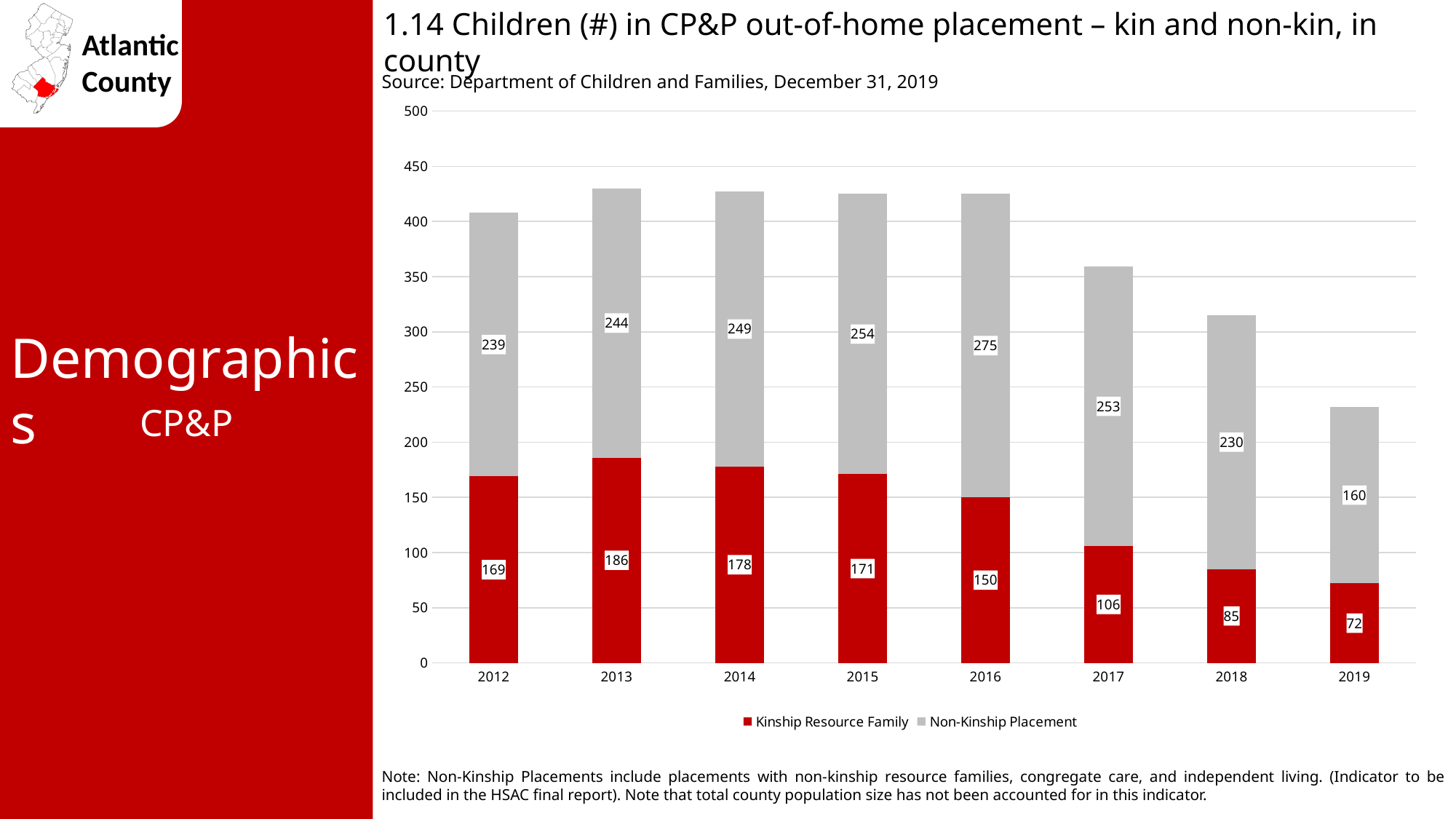
Does the Kinship Resource Family value rise or fall from 2015 to 2019? Fall Which year has the highest Non-Kinship Placement value? 2016 Which year has the lowest Kinship Resource Family value? 2019 What is the difference between the Non-Kinship Placement value and the Kinship Resource Family value in 2017? 147 What is the source cited for the chart data? Department of Children and Families, December 31, 2019 What is the Kinship Resource Family value for 2013? 186 How many years are shown on the x axis? 8 What is the Non-Kinship Placement value for 2016? 275 How many series does the legend list? 2 Which is larger in 2014: the Kinship Resource Family value or the Non-Kinship Placement value? Non-Kinship Placement What is the total number of children in out-of-home placement in 2019 (both series combined)? 232 What type of chart is shown on the slide? Stacked bar chart